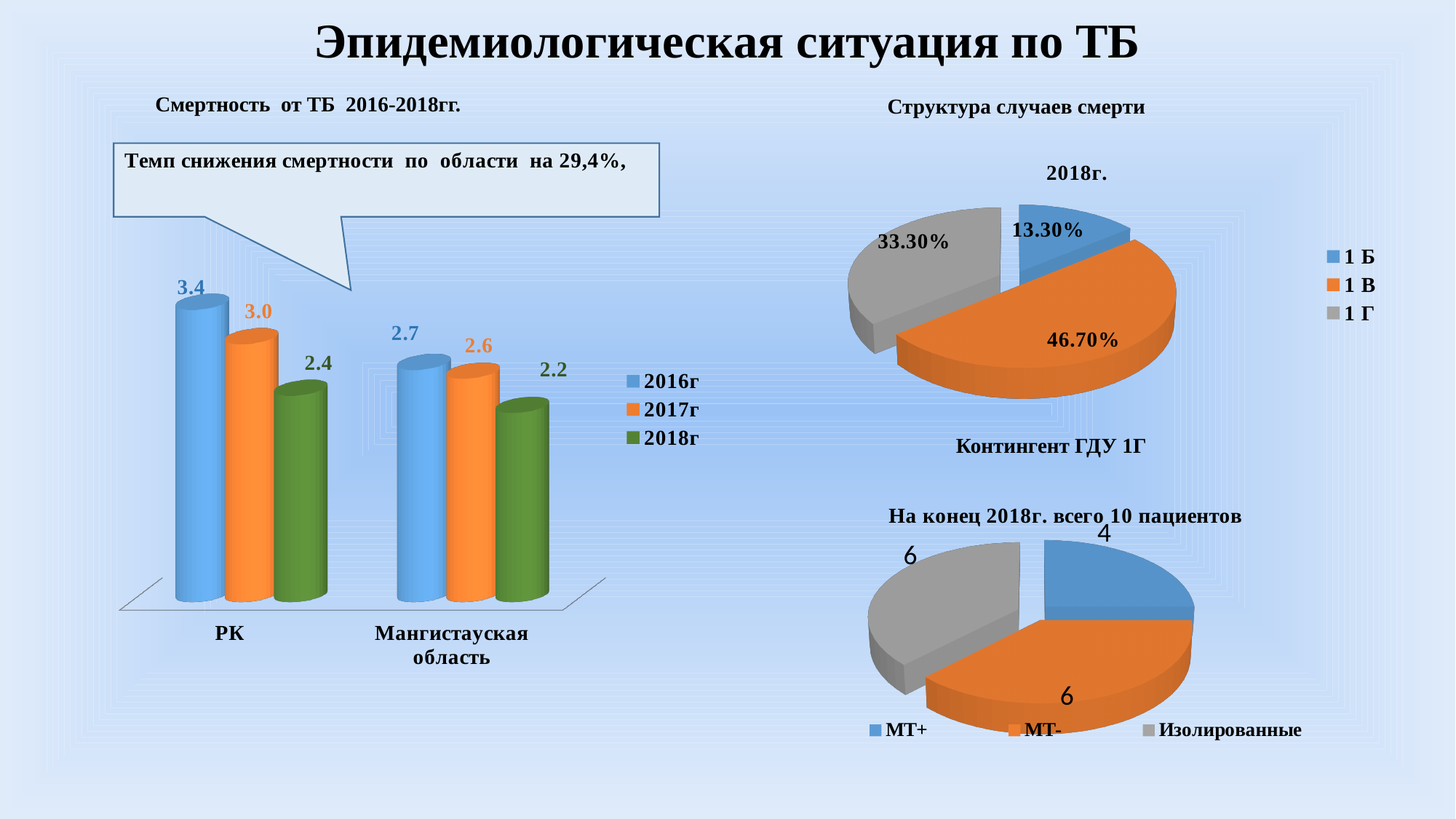
In the bar chart 'Смертность от ТБ 2016-2018гг.', do the values for РК rise or fall from 2016г to 2018г? fall What kind of chart is 'Структура случаев смерти'? pie chart How many categories does the legend of the pie chart 'Контингент ГДУ 1Г' list? 3 In the bar chart 'Смертность от ТБ 2016-2018гг.', what is the difference between the 2016г and 2018г values for РК? 1.0 In the pie chart 'Контингент ГДУ 1Г', what is the value for МТ+? 4 In the bar chart 'Смертность от ТБ 2016-2018гг.', which is larger: the 2017г value for РК or the 2017г value for Мангистауская область? РК In the pie chart 'Структура случаев смерти', what share does 1 В have? 46.70% In the bar chart 'Смертность от ТБ 2016-2018гг.', what is the value for Мангистауская область in 2018г? 2.2 In the bar chart 'Смертность от ТБ 2016-2018гг.', which year has the highest value for Мангистауская область? 2016г How many series does the legend of the bar chart 'Смертность от ТБ 2016-2018гг.' list? 3 In the pie chart 'Структура случаев смерти', which category has the smallest share? 1 Б In the bar chart 'Смертность от ТБ 2016-2018гг.', what is the value for РК in 2016г? 3.4